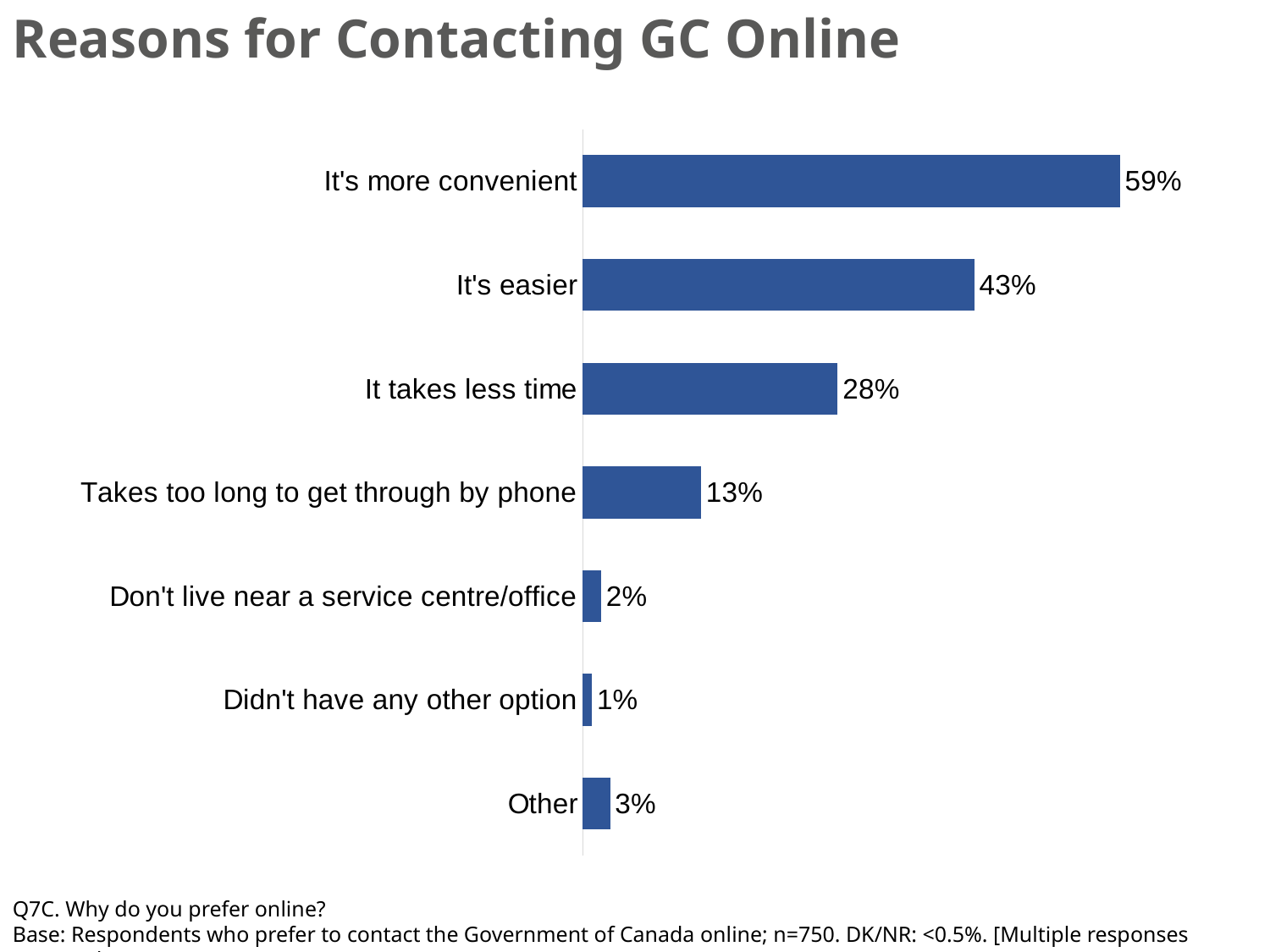
How many reasons are shown in the chart? 7 What kind of chart is shown on the slide? Bar chart What is the sample size (n) stated in the base note? n=750 Which reason has the lowest percentage? Didn't have any other option What is the difference between "It takes less time" and "Takes too long to get through by phone"? 15% What percentage is shown for "Other"? 3% What is the title of the chart? Reasons for Contacting GC Online What is the value for "Takes too long to get through by phone"? 13% Which is larger: "Don't live near a service centre/office" or "Other"? Other What is the difference between "It's more convenient" and "It's easier"? 16% Which reason has the highest percentage? It's more convenient What percentage of respondents said "It's more convenient"? 59%